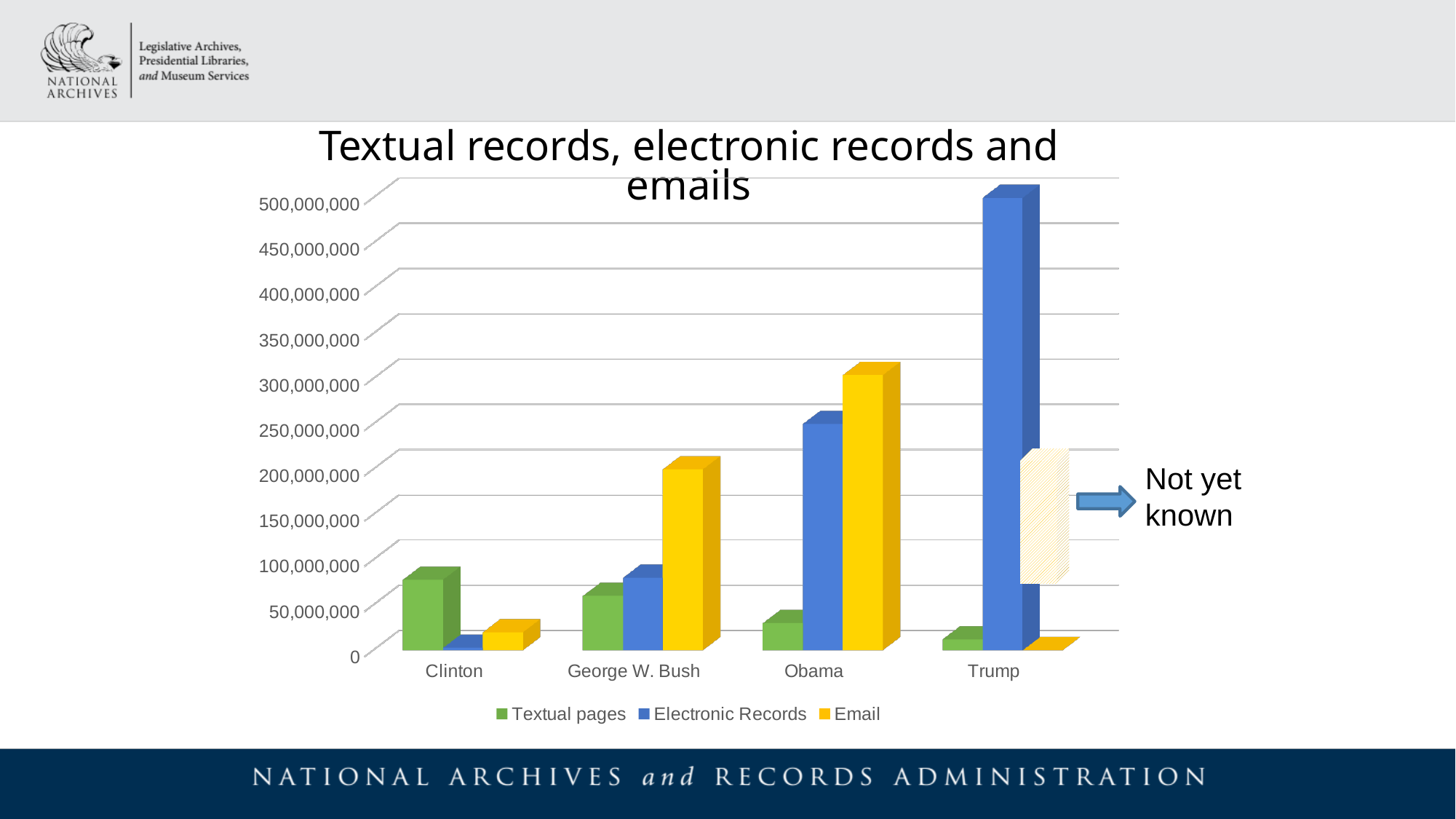
Which president has the highest Electronic Records value? Trump Is the Electronic Records value for Trump greater or less than 400,000,000? greater What kind of chart is shown on the slide? Bar chart Do the Textual pages values rise or fall from Clinton to Trump? fall How many series does the legend list? 3 Is the Textual pages value for Clinton greater or less than 100,000,000? less What does the annotation next to the Trump bars say? Not yet known How many presidents are shown on the x axis? 4 Which president has the lowest Textual pages value? Trump Which president has the highest Textual pages value? Clinton Which is larger, the Email value for Obama or the Email value for George W. Bush? Obama Is the Email value for Obama greater or less than 250,000,000? greater